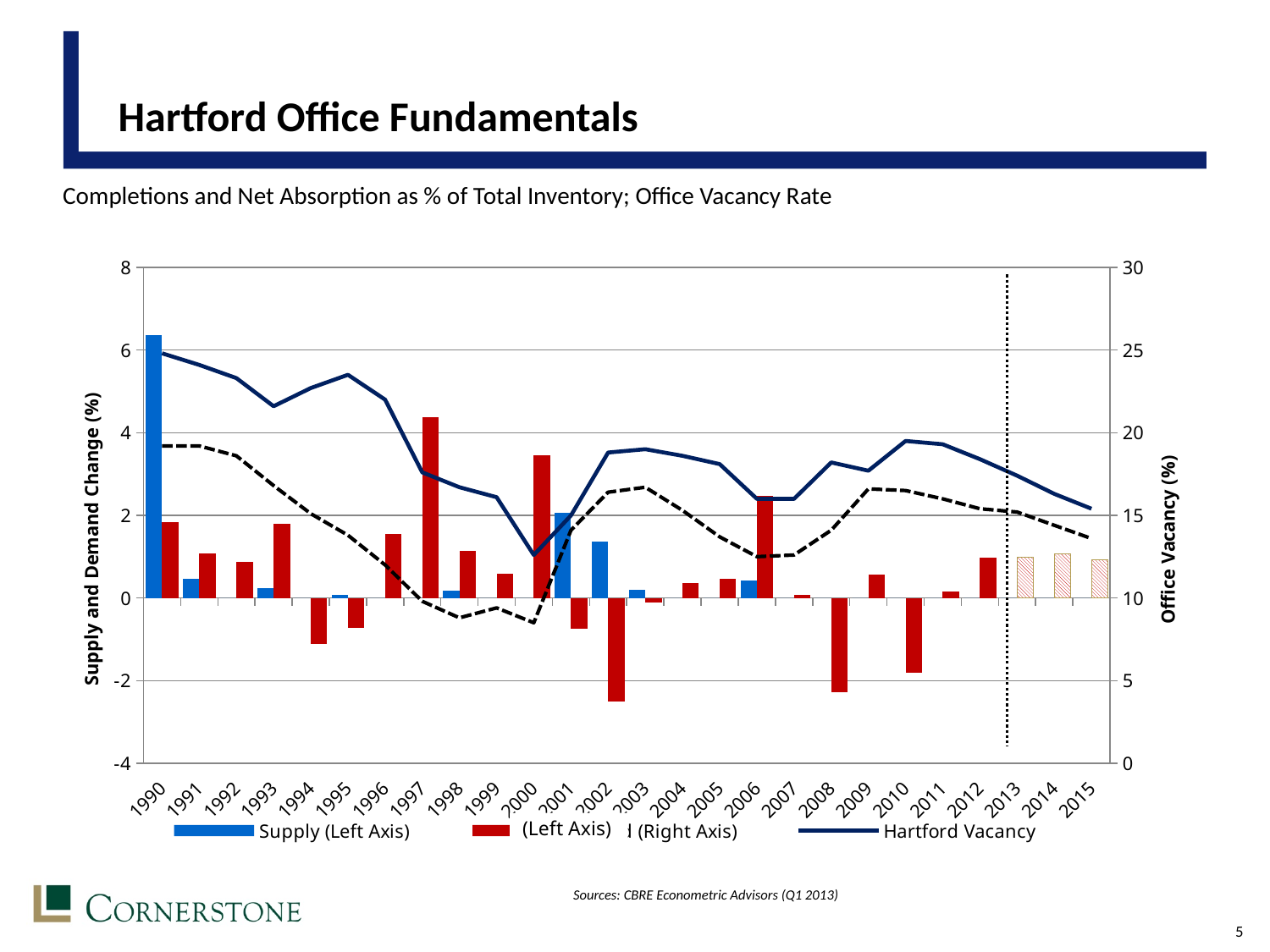
Is the Supply (Left Axis) value for 1990 greater or less than 4? greater What is the title of the slide containing the chart? Hartford Office Fundamentals Is the Hartford Vacancy value for 2000 greater or less than 15? less Does the Hartford Vacancy line rise or fall from 1990 to 2000? Fall What kind of chart is shown on the slide? A combination bar and line chart What is the label of the right-hand vertical axis? Office Vacancy (%) Is the red (Left Axis) bar for 2002 greater or less than -2? less Which is larger, the Supply (Left Axis) bar for 1990 or the Supply (Left Axis) bar for 2001? 1990 Which year has the tallest Supply (Left Axis) bar? 1990 How many years are shown along the x axis of the chart? 26